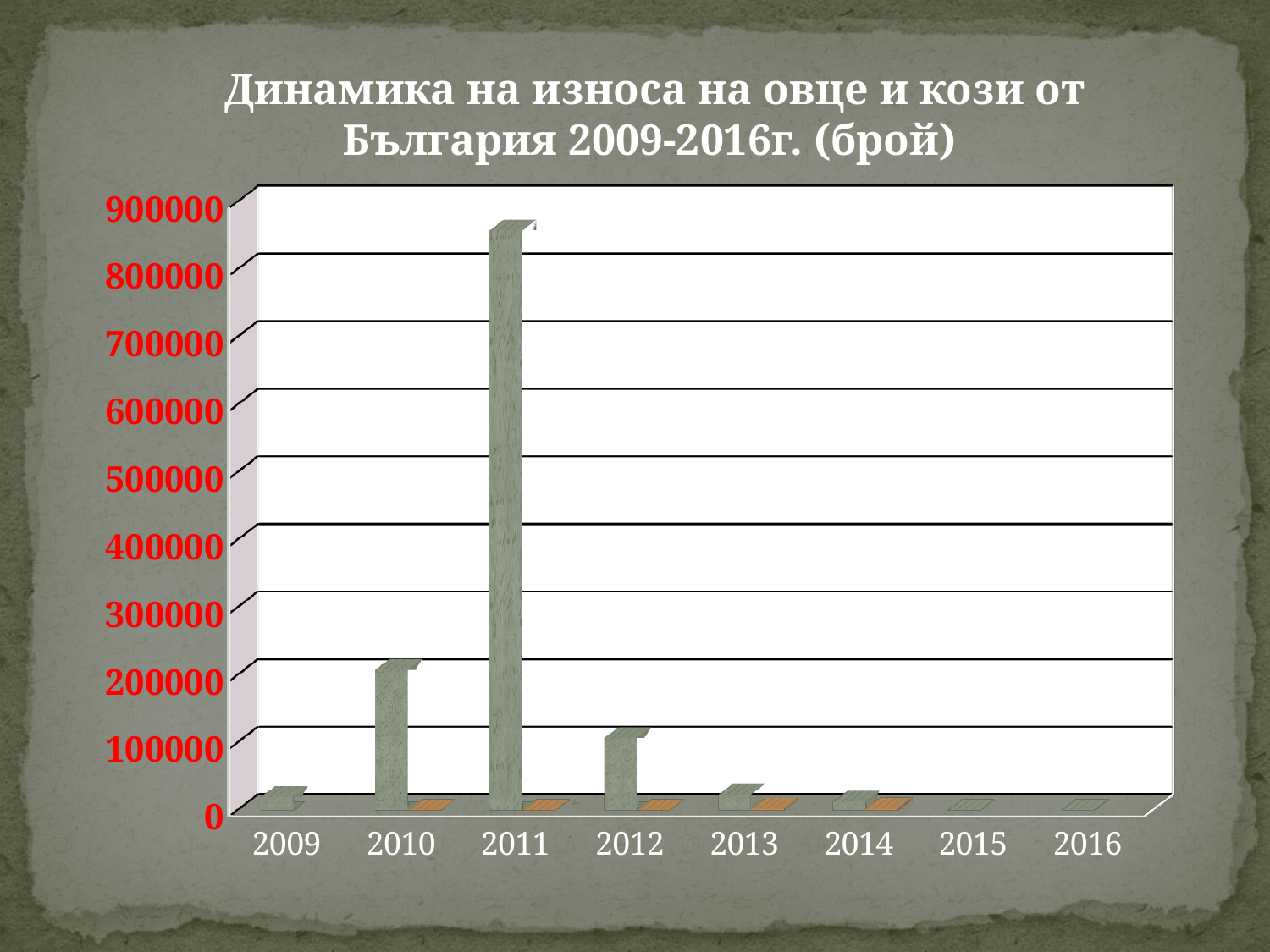
Is the value for 2009 greater or less than 100000? less Which year has the larger value, 2012 or 2013? 2012 How many years are shown on the x axis of the chart? 8 Is the value for 2010 greater or less than 300000? less Is the value for 2013 greater or less than 100000? less Do the values rise or fall from 2011 to 2016? fall Which year has the highest value in the chart? 2011 What is the title of the chart? Динамика на износа на овце и кози от България 2009-2016г. (брой) Which year has the larger value, 2010 or 2012? 2010 What kind of chart is shown on the slide? bar chart